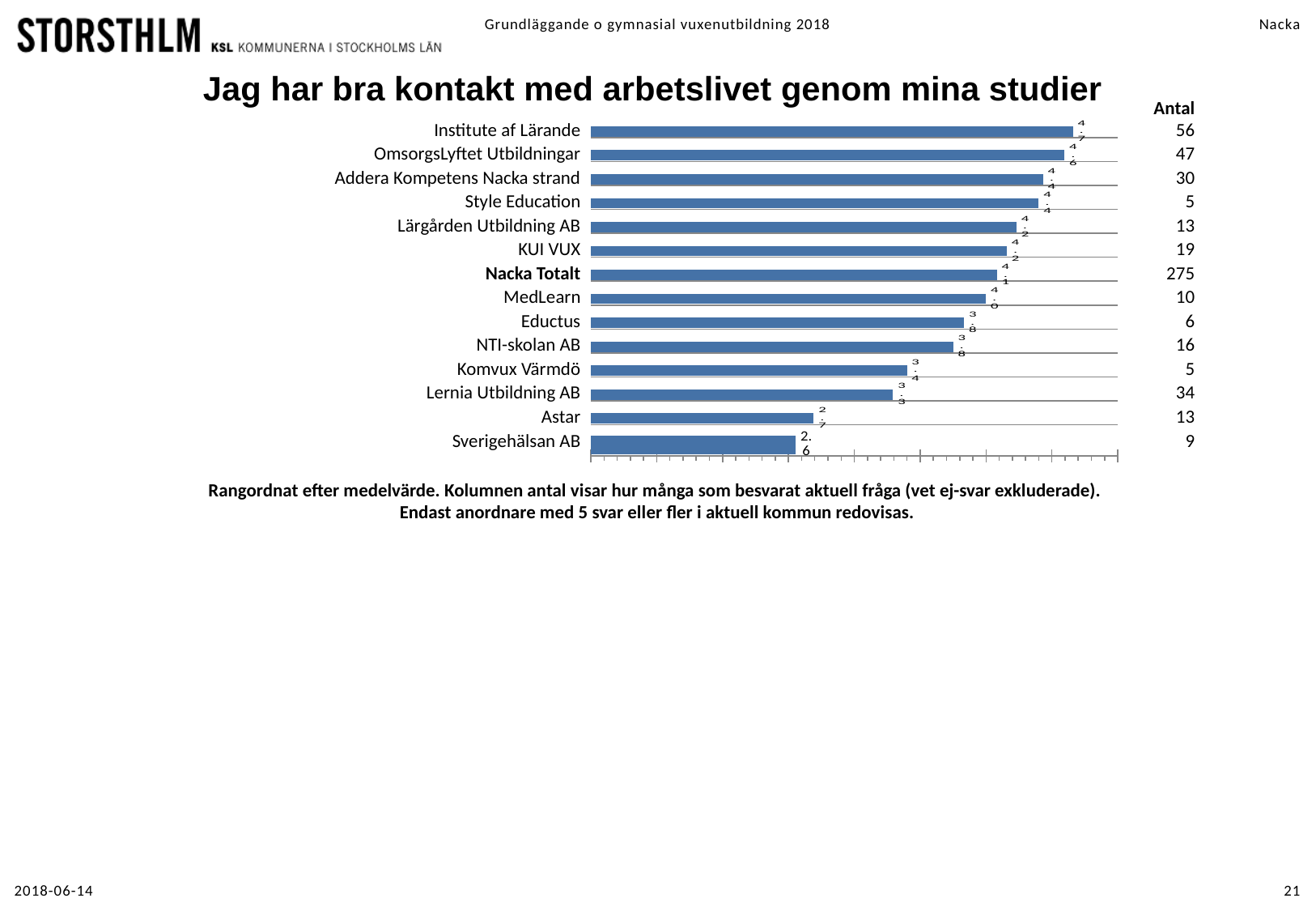
Which has a larger value, MedLearn or Astar? MedLearn Which category has the lowest value? Sverigehälsan AB How many categories are shown in the chart? 14 What is the difference between the values for Nacka Totalt and Astar? 1.4 What is the difference between the values for Institute af Lärande and Sverigehälsan AB? 2.1 What is the value shown for Institute af Lärande? 4.7 What is the title of the chart? Jag har bra kontakt med arbetslivet genom mina studier What kind of chart is shown on the slide? Bar chart What is the value shown for Lernia Utbildning AB? 3.3 What is the value shown for Nacka Totalt? 4.1 Which category has the highest value? Institute af Lärande What is the value shown for Sverigehälsan AB? 2.6